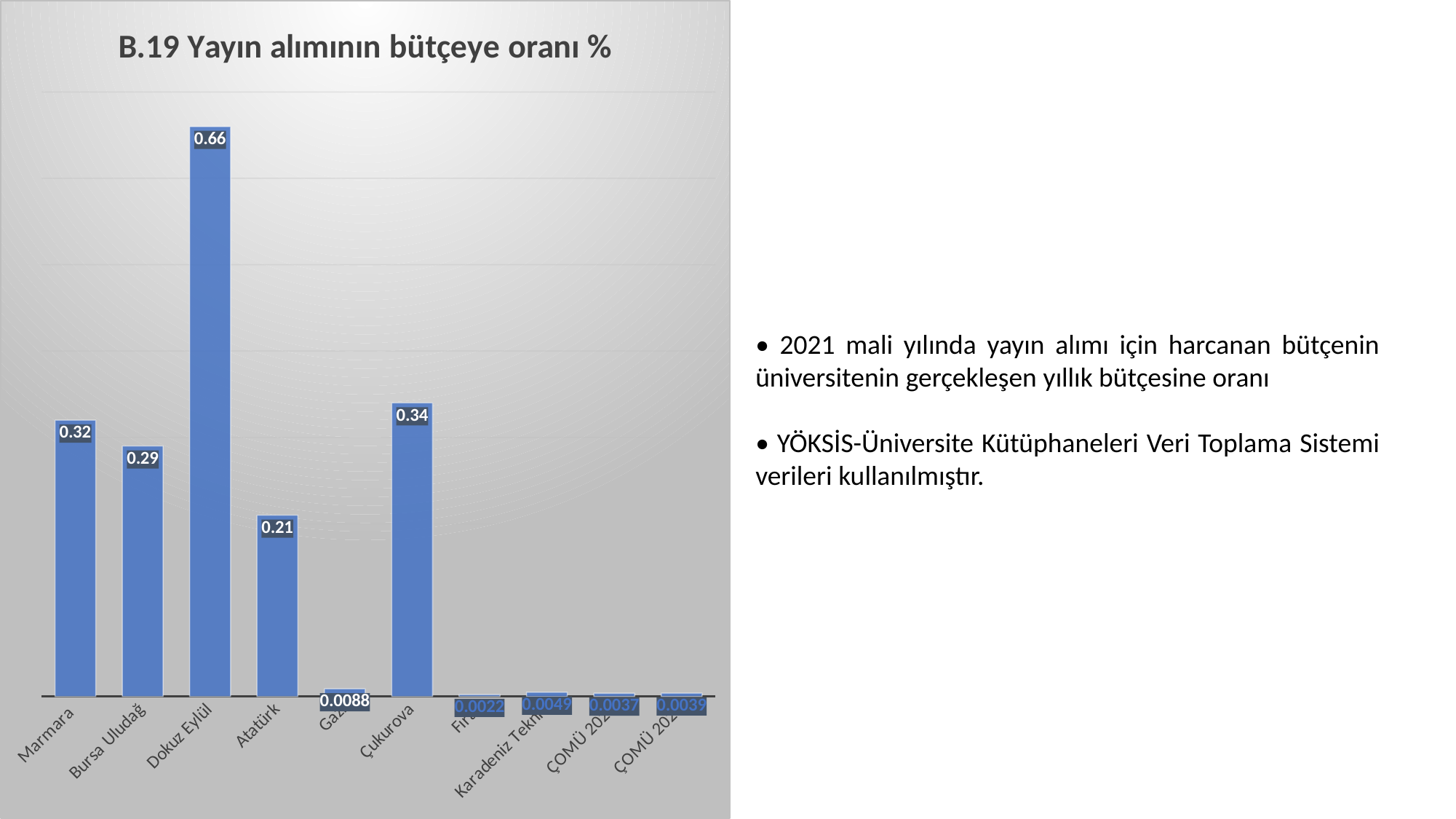
What is the difference between the values for Marmara and Bursa Uludağ? 0.03 What is the difference between the values for Dokuz Eylül and Çukurova? 0.32 What is the value for Çukurova? 0.34 Which university has the highest value in the chart? Dokuz Eylül What is the title of the chart? B.19 Yayın alımının bütçeye oranı % How many bars are plotted in the chart? 10 What is the smallest value labelled in the chart? 0.0022 What is the value for Dokuz Eylül? 0.66 What is the value for Marmara? 0.32 What is the value for Atatürk? 0.21 What kind of chart is shown on the slide? bar chart Which is larger, the value for Bursa Uludağ or the value for Atatürk? Bursa Uludağ